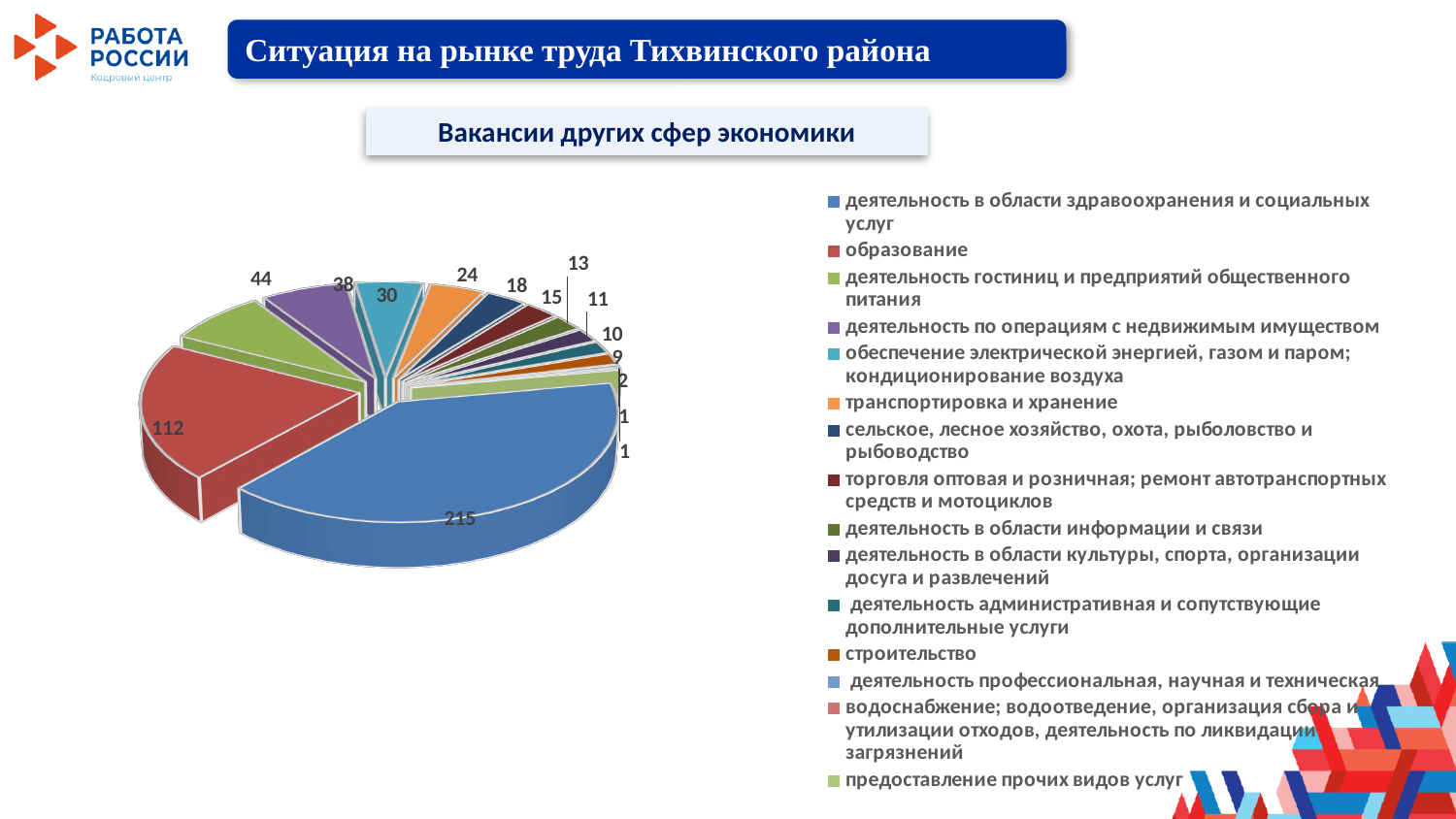
What is the difference between the values for здравоохранение и социальные услуги and образование? 103 What is the title shown above the chart? Вакансии других сфер экономики How many categories does the legend of the pie chart list? 15 What is the value for строительство? 9 What is the value for образование? 112 What kind of chart is shown on the slide? pie chart What is the value for деятельность в области здравоохранения и социальных услуг? 215 Which category has the largest slice of the pie? деятельность в области здравоохранения и социальных услуг What is the value for деятельность гостиниц и предприятий общественного питания? 44 What is the smallest value shown on the pie chart? 1 Which is larger: деятельность по операциям с недвижимым имуществом or обеспечение электрической энергией, газом и паром? деятельность по операциям с недвижимым имуществом What is the value for транспортировка и хранение? 24